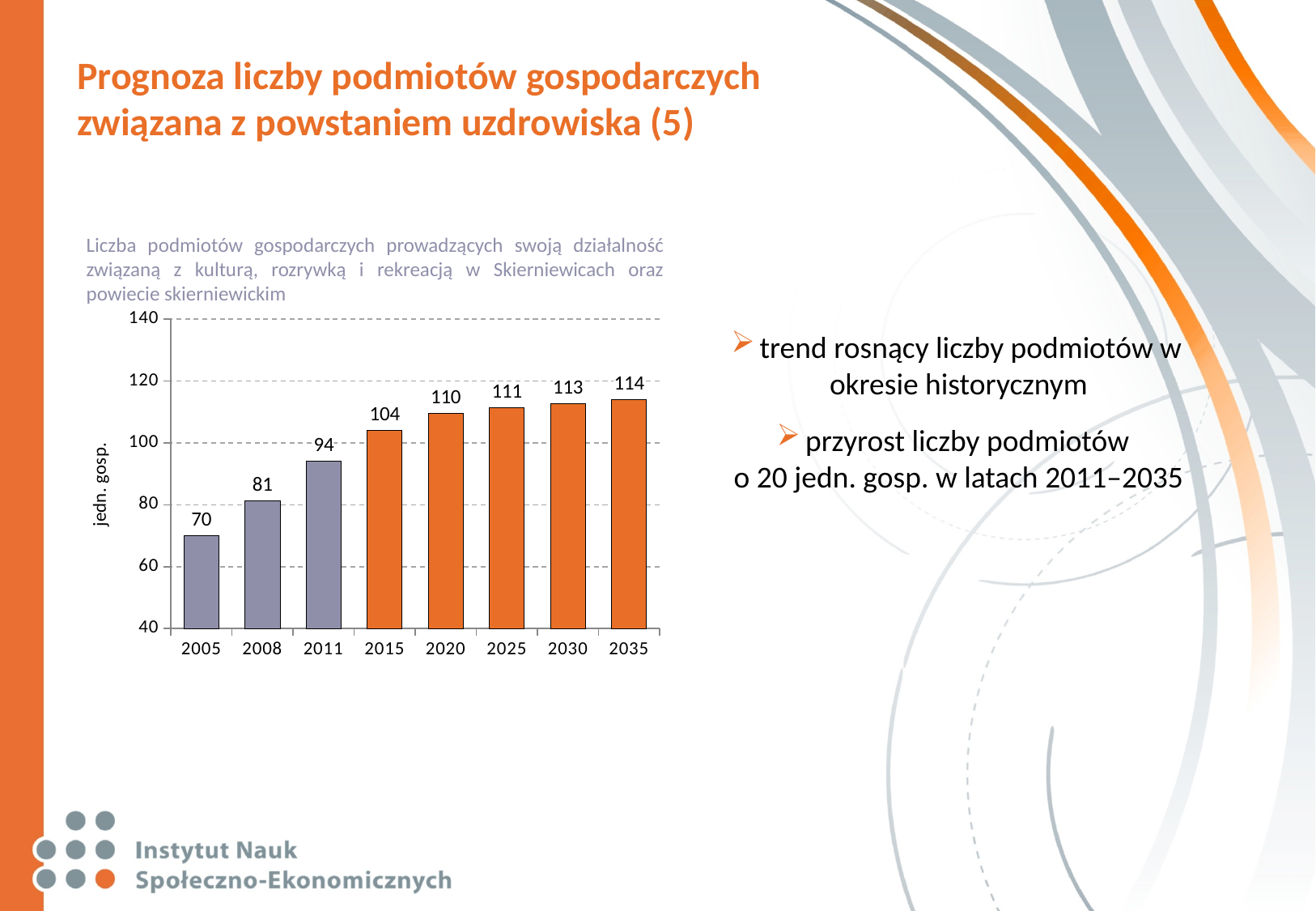
Which is larger, the value for 2015 or the value for 2008? 2015 What is the value for 2035? 114 What is the label on the y axis? jedn. gosp. What kind of chart is this? bar chart Which year has the lowest value? 2005 What is the difference between the values for 2035 and 2011? 20 What is the value for 2011? 94 What is the difference between the values for 2008 and 2005? 11 Which year has the highest value? 2035 What is the value for 2005? 70 How many years are shown on the x axis? 8 Do the values rise or fall from 2005 to 2035? rise